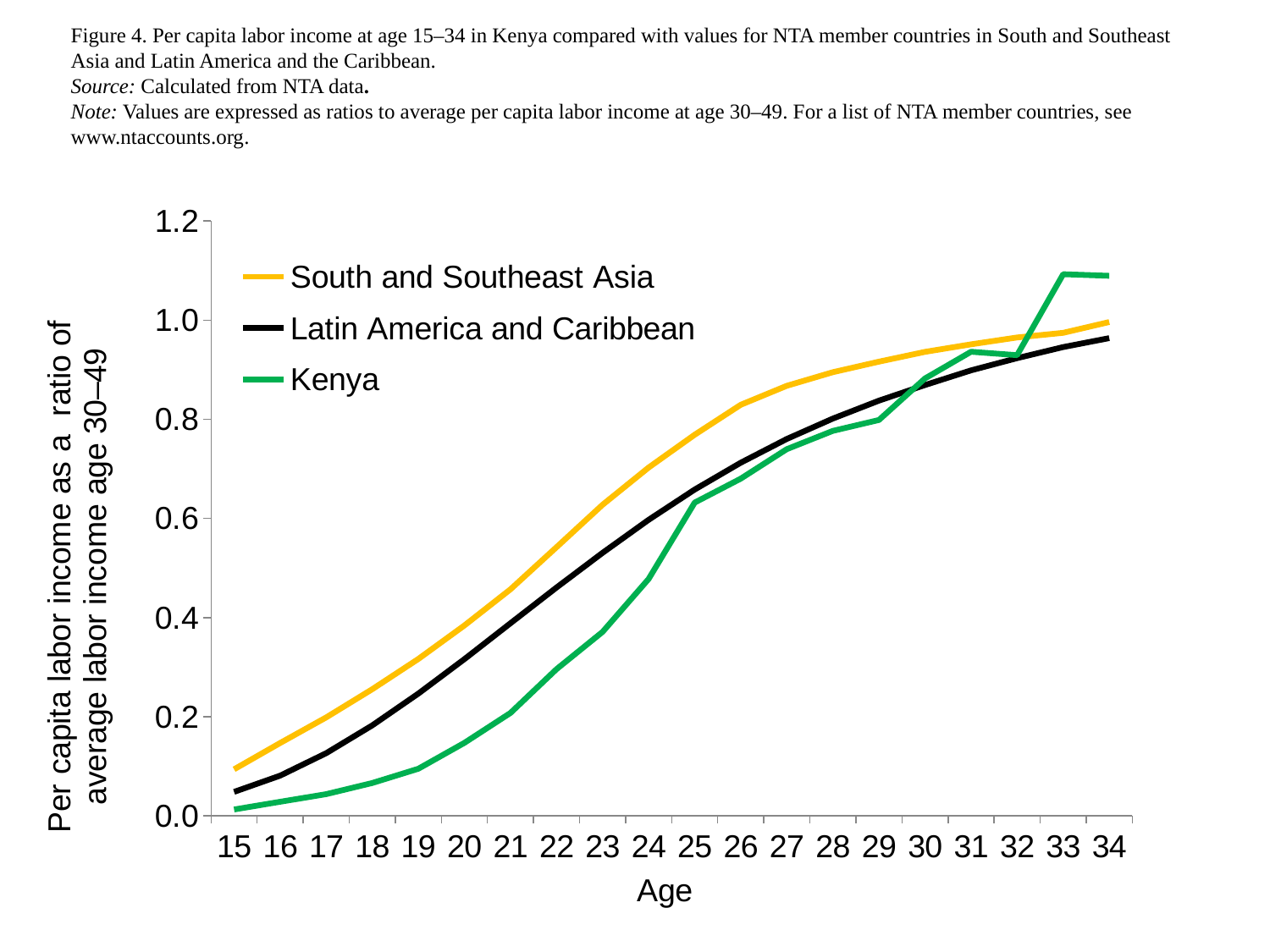
Do the values for Kenya generally rise or fall as age increases from 15 to 34? rise At age 20, which is larger: the value for South and Southeast Asia or the value for Kenya? South and Southeast Asia Is the value for Kenya at age 20 greater or less than 0.2? less Which series has the highest value at age 34? Kenya How many ages are shown along the x axis? 20 What colour is the line for Kenya? green At age 33, which is larger: the value for Kenya or the value for Latin America and Caribbean? Kenya How many series does the legend list? 3 What kind of chart is shown on the slide? line chart Is the value for Kenya at age 33 greater or less than 1.0? greater Which series has the lowest value at age 15? Kenya Is the value for South and Southeast Asia at age 26 greater or less than 0.8? greater